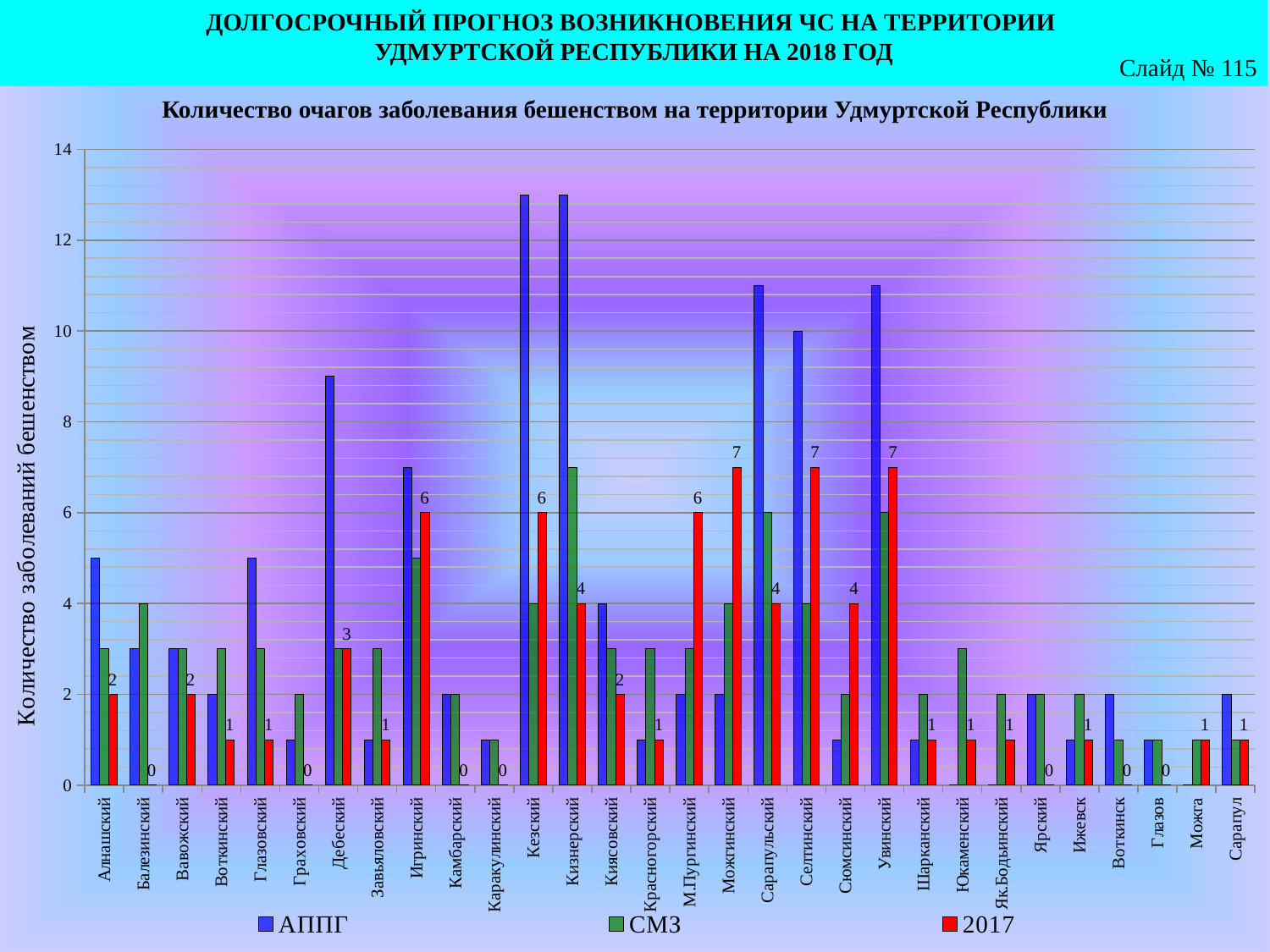
Is the АППГ value for Дебесский greater or less than 8? greater What is the 2017 value for Дебесский? 3 Which has the larger 2017 value, Кизнерский or Киясовский? Кизнерский What is the 2017 value for Игринский? 6 How many series does the legend list? 3 How many categories are shown on the x axis? 30 Is the АППГ value for Кезский greater or less than 12? greater What kind of chart is shown on the slide? bar chart What is the 2017 value for Можгинский? 7 What is the difference between the 2017 values for Игринский and Дебесский? 3 What is the 2017 value for Сюмсинский? 4 Is the СМЗ value for Кизнерский greater or less than 6? greater